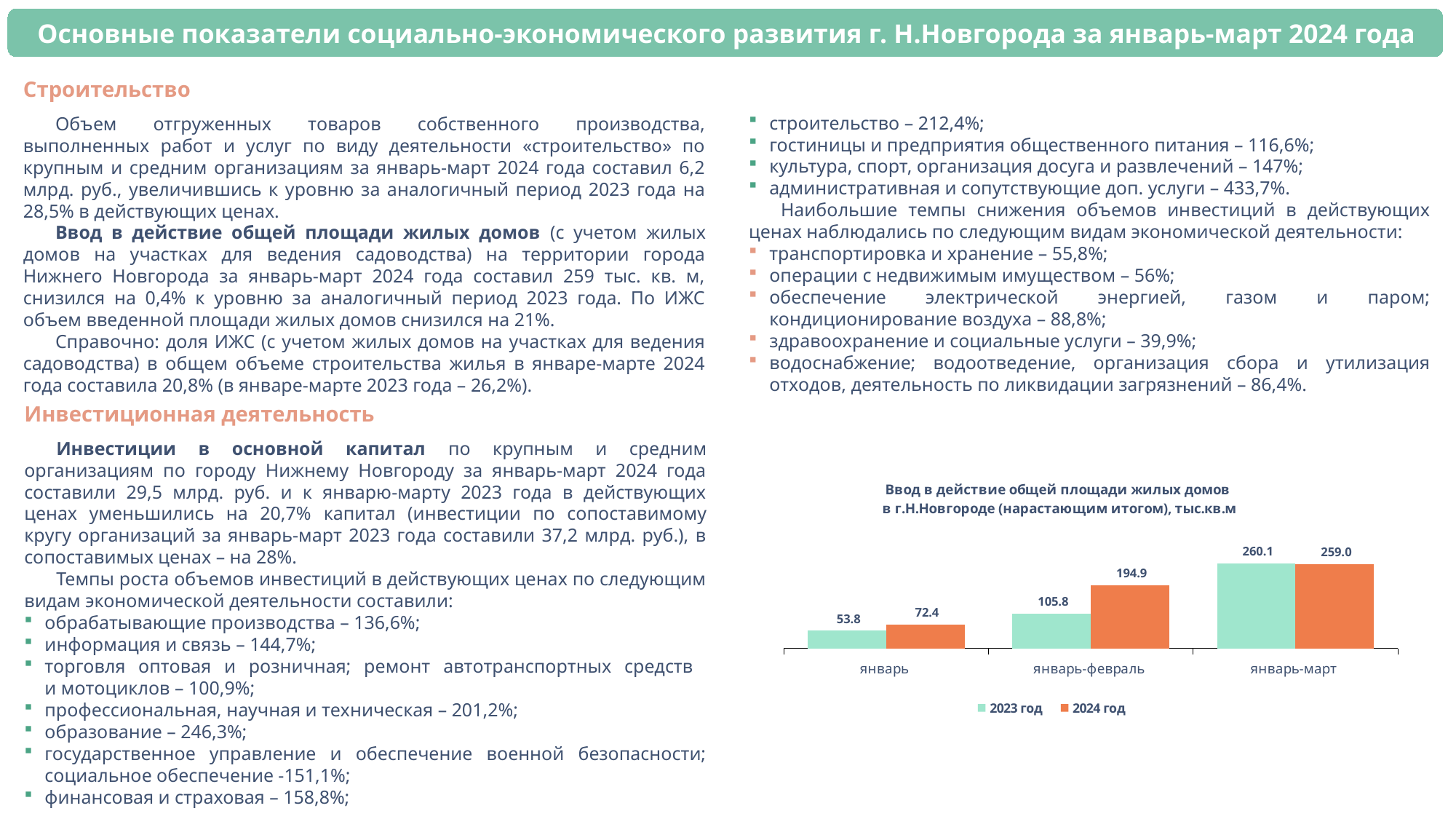
What is the value for 2024 год in январь-март? 259.0 What is the difference between the 2024 год and 2023 год values in январь-февраль? 89.1 What is the value for 2024 год in январь-февраль? 194.9 How many series does the legend list? 2 What is the value for 2023 год in январь-март? 260.1 Which category has the lowest value for the 2023 год series? январь Do the values for the 2023 год series rise or fall from январь to январь-март? rise How many categories are shown on the x axis of the chart? 3 What is the value for 2023 год in январь? 53.8 Which is larger in январь: the 2023 год value or the 2024 год value? 2024 год What kind of chart is shown on the slide? bar chart Which category has the highest value for the 2024 год series? январь-март